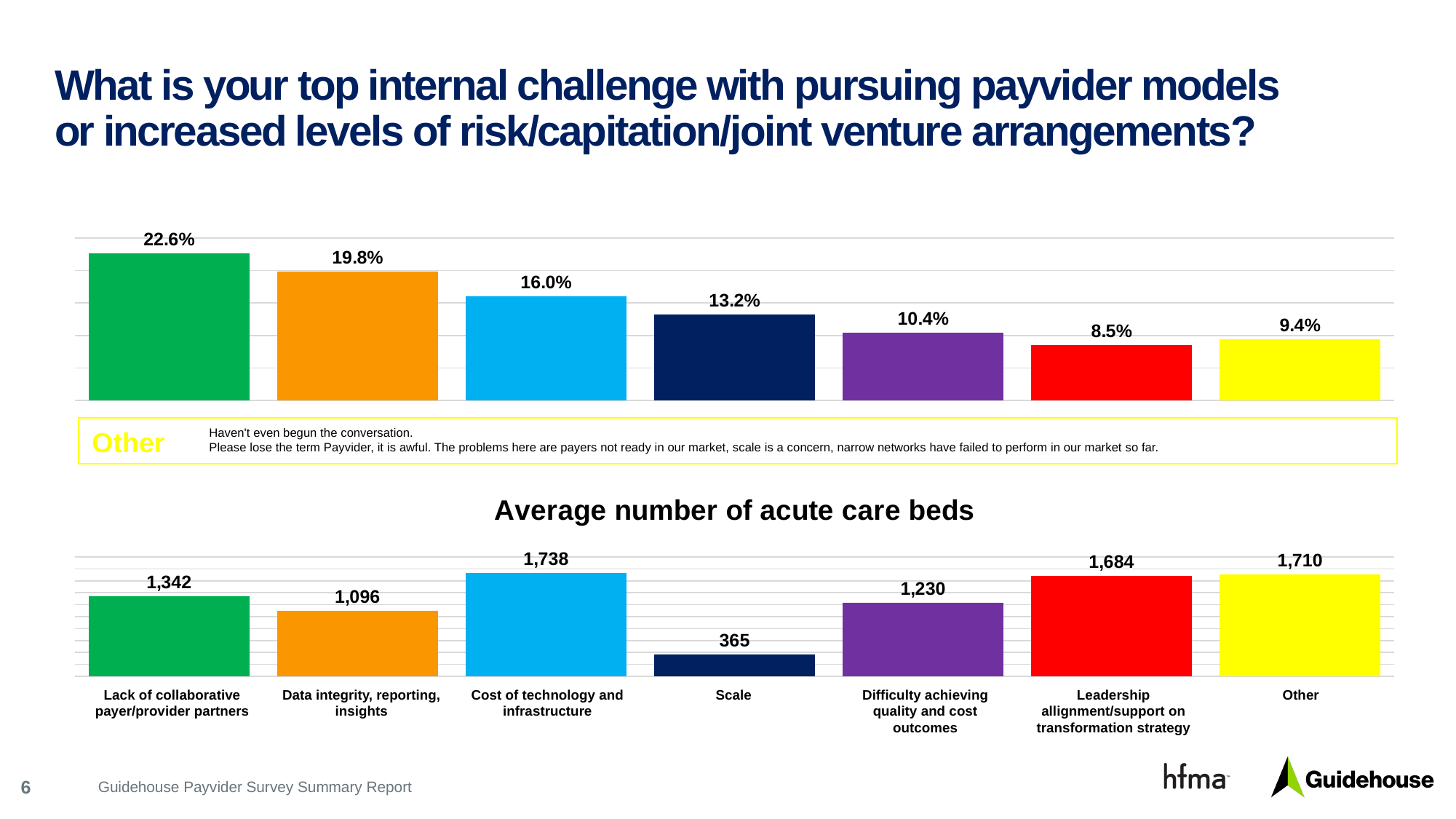
In the top chart, what is the difference between the percentages for Lack of collaborative payer/provider partners and Data integrity, reporting, insights? 2.8 percentage points What type of chart is the Average number of acute care beds chart? Bar chart In the Average number of acute care beds chart, what is the value for Scale? 365 In the Average number of acute care beds chart, what is the difference between the values for Cost of technology and infrastructure and Other? 28 In the Average number of acute care beds chart, which category has the highest value? Cost of technology and infrastructure In the Average number of acute care beds chart, which category has the lowest value? Scale In the Average number of acute care beds chart, what colour is the bar for Scale? Dark navy blue In the top chart, which is larger: the percentage for Other or for Leadership allignment/support on transformation strategy? Other In the top chart, which category has the lowest percentage? Leadership allignment/support on transformation strategy In the top chart, what percentage is shown for Scale? 13.2% In the top chart, which category has the highest percentage? Lack of collaborative payer/provider partners How many categories are shown in the Average number of acute care beds chart? 7